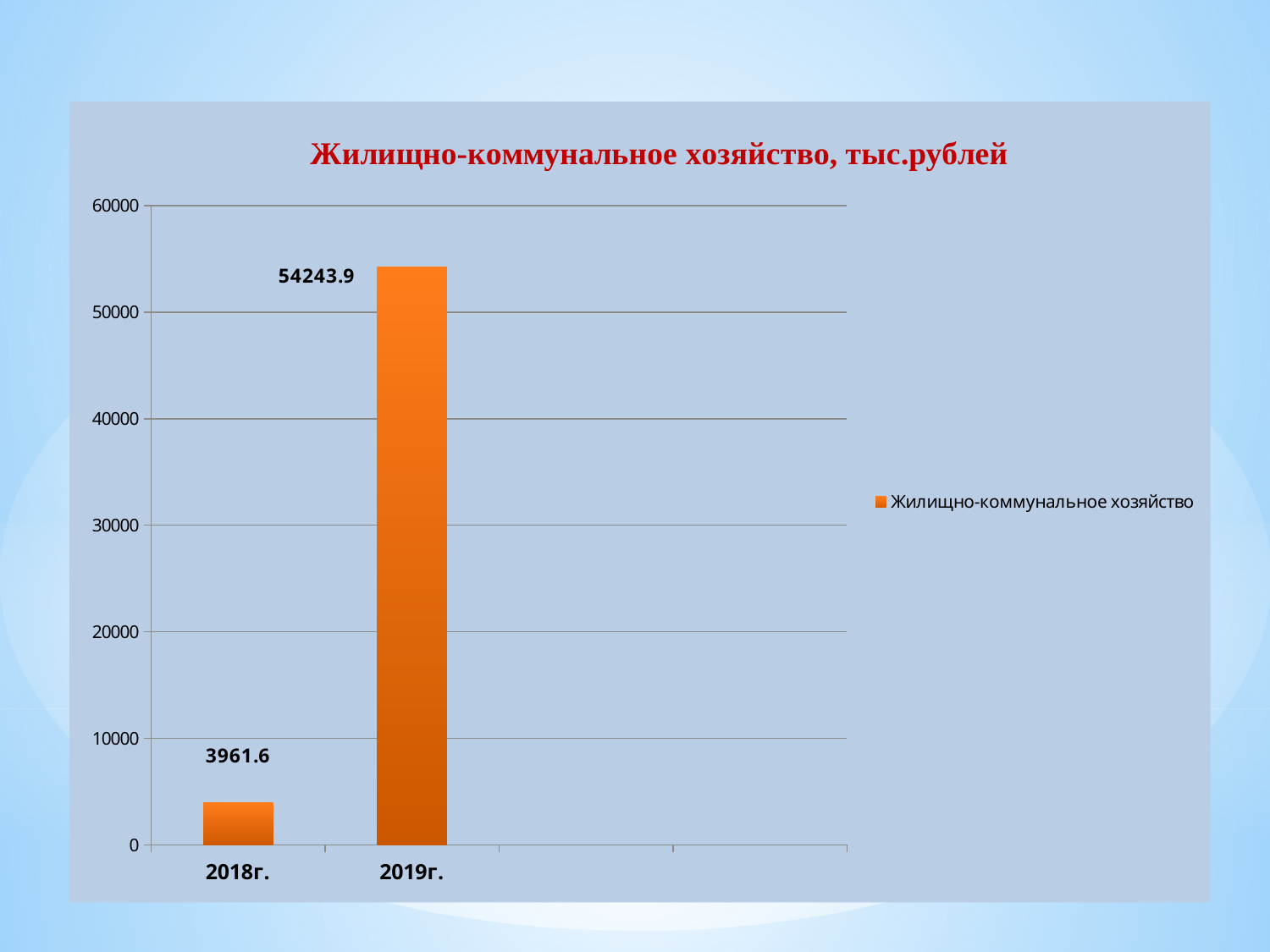
Which year has the lowest value? 2018г. How many series does the legend list? 1 What is the value for 2018г.? 3961.6 What is the difference between the values for 2019г. and 2018г.? 50282.3 What is the title of the chart? Жилищно-коммунальное хозяйство, тыс.рублей What kind of chart is this? bar chart Is the value for 2019г. greater or less than 50000? greater What is the value for 2019г.? 54243.9 Is the value for 2018г. greater or less than 10000? less How many categories are shown on the x axis? 2 Which is larger, the value for 2018г. or the value for 2019г.? 2019г. Which year has the highest value? 2019г.